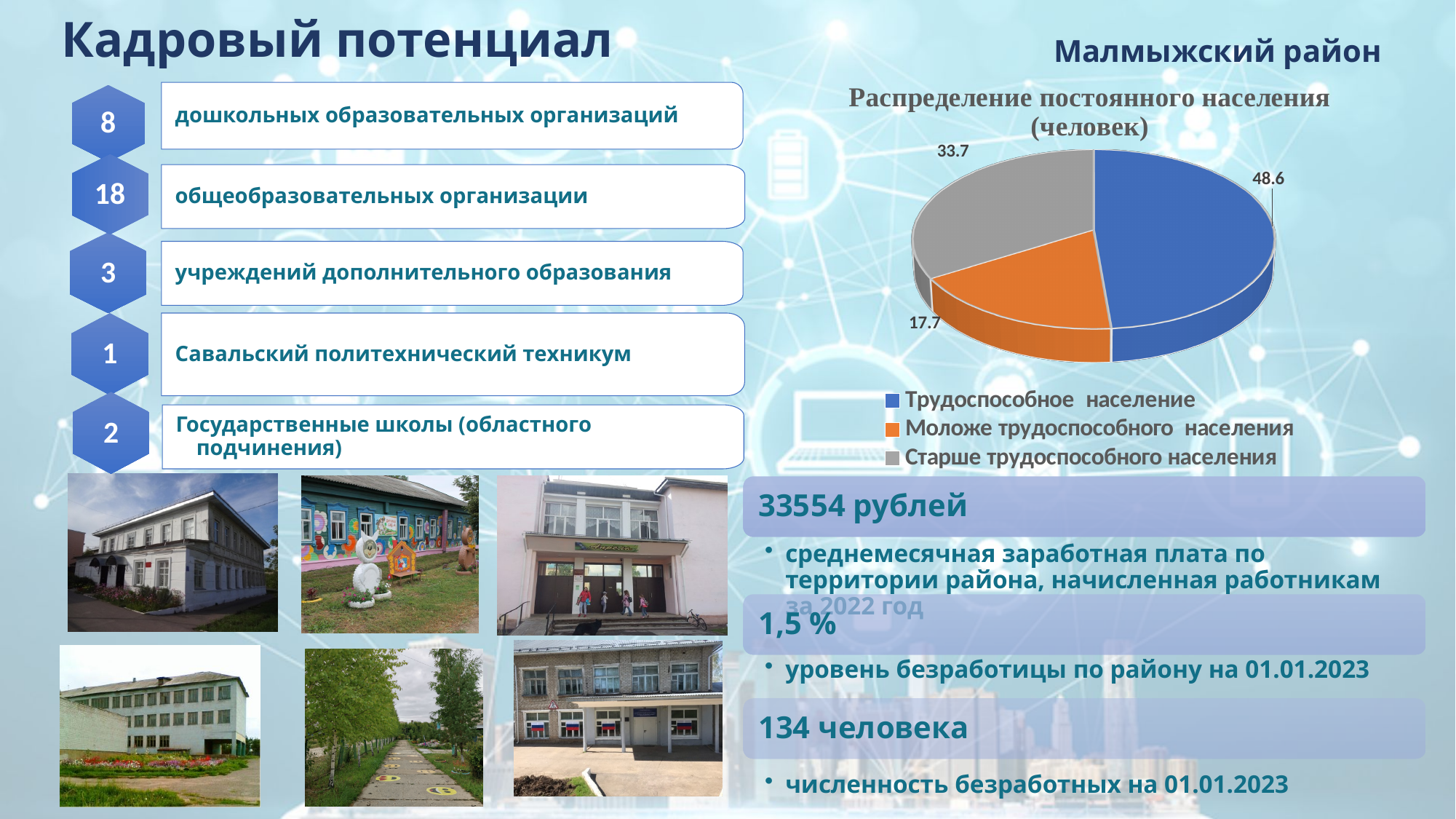
Which category has the largest slice in the pie chart? Трудоспособное население Which category has the smallest slice in the pie chart? Моложе трудоспособного населения What is the value for Трудоспособное население in the pie chart? 48.6 Which is larger: Старше трудоспособного населения or Моложе трудоспособного населения? Старше трудоспособного населения What is the title of the pie chart? Распределение постоянного населения (человек) What is the difference between the values for Трудоспособное население and Старше трудоспособного населения? 14.9 What colour is the slice for Моложе трудоспособного населения? orange What is the value for Моложе трудоспособного населения in the pie chart? 17.7 What is the value for Старше трудоспособного населения in the pie chart? 33.7 What type of chart is shown on the slide? pie chart How many slices does the pie chart have? 3 What is the difference between the values for Старше трудоспособного населения and Моложе трудоспособного населения? 16